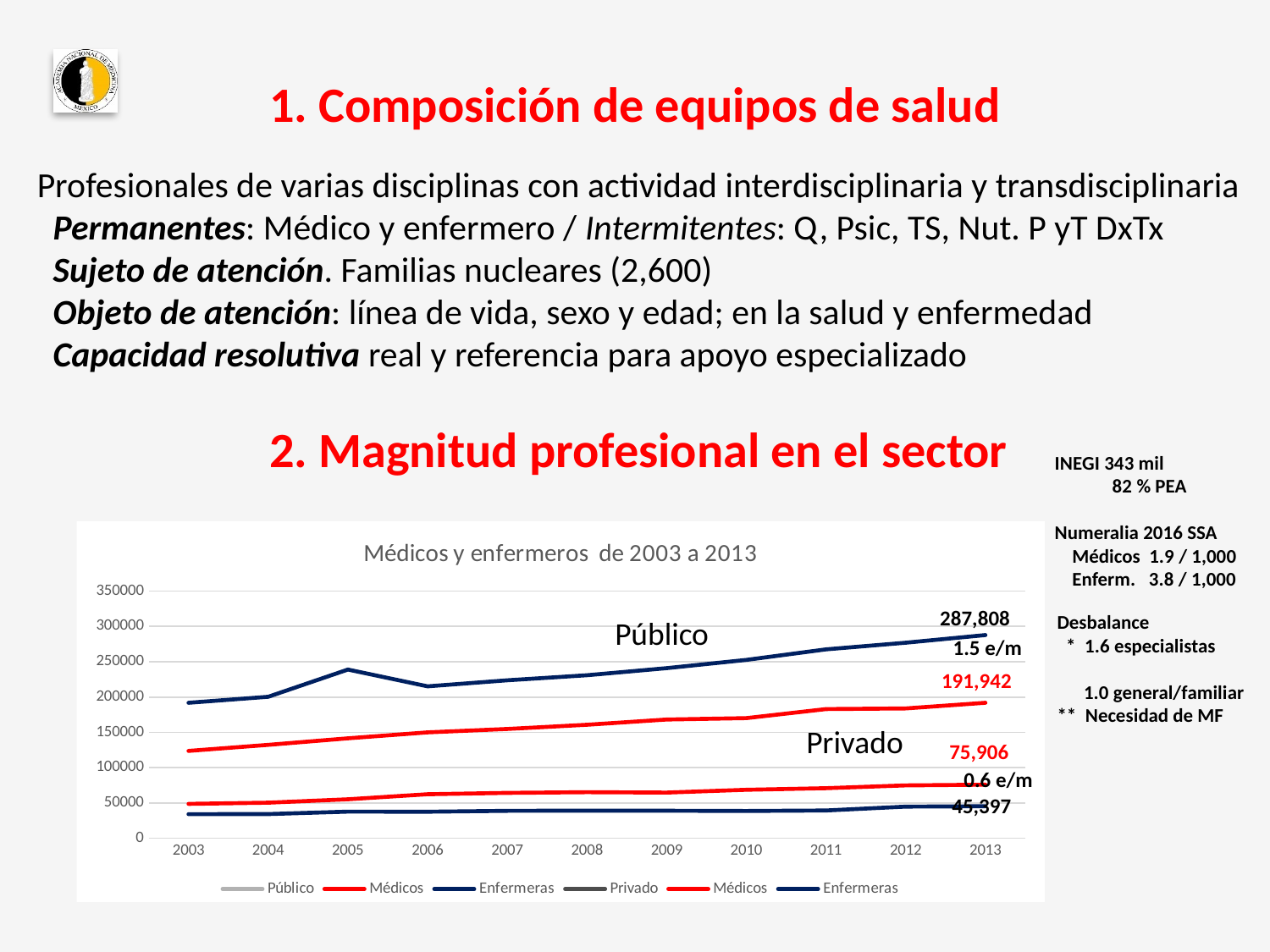
What is the difference between the 2013 values for Médicos (75,906) and Enfermeras (45,397) in the Privado sector? 30,509 What is the labelled value for Médicos in the Privado sector in 2013? 75,906 How many series does the chart legend list? 6 What is the title of the chart? Médicos y enfermeros de 2003 a 2013 What is the labelled value for Médicos in the Público sector in 2013? 191,942 What is the difference between the 2013 values for Enfermeras (287,808) and Médicos (191,942) in the Público sector? 95,866 Does the Público Médicos line rise or fall from 2003 to 2013? rise How many years are shown on the x axis of the chart? 11 What is the labelled value for Enfermeras in the Privado sector in 2013? 45,397 What kind of chart is shown on the slide? line chart Is the value for Público Médicos in 2003 greater or less than 150000? less What is the labelled value for Enfermeras in the Público sector in 2013? 287,808